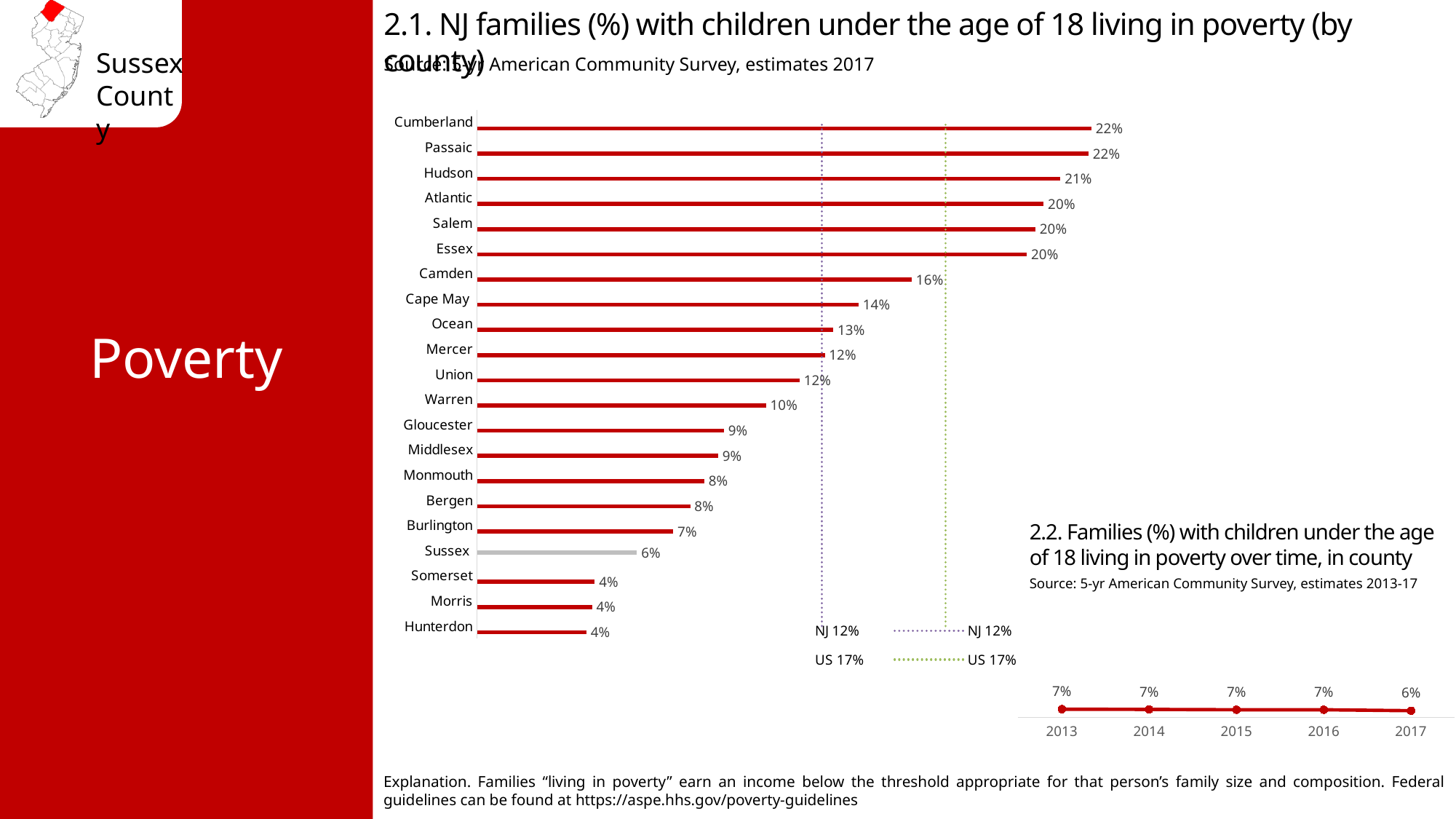
In chart 2.2, do the values rise or fall from 2013 to 2017? Fall In chart 2.1, which has a higher value, Cape May or Ocean? Cape May In chart 2.1, what is the value shown for Camden? 16% In chart 2.1, what percentage of families with children under 18 live in poverty in Sussex County? 6% In chart 2.1, what is the US reference value marked by the dotted line? 17% In chart 2.2, how many years are plotted? 5 In chart 2.1, what is the NJ reference value marked by the dotted line? 12% In chart 2.1, what is the difference between the values for Hudson and Sussex? 15% In chart 2.2, what is the value for 2017? 6% In chart 2.1, what is the value shown for Cumberland? 22% In chart 2.1, how many counties are plotted? 21 What kind of chart is chart 2.1? Bar chart